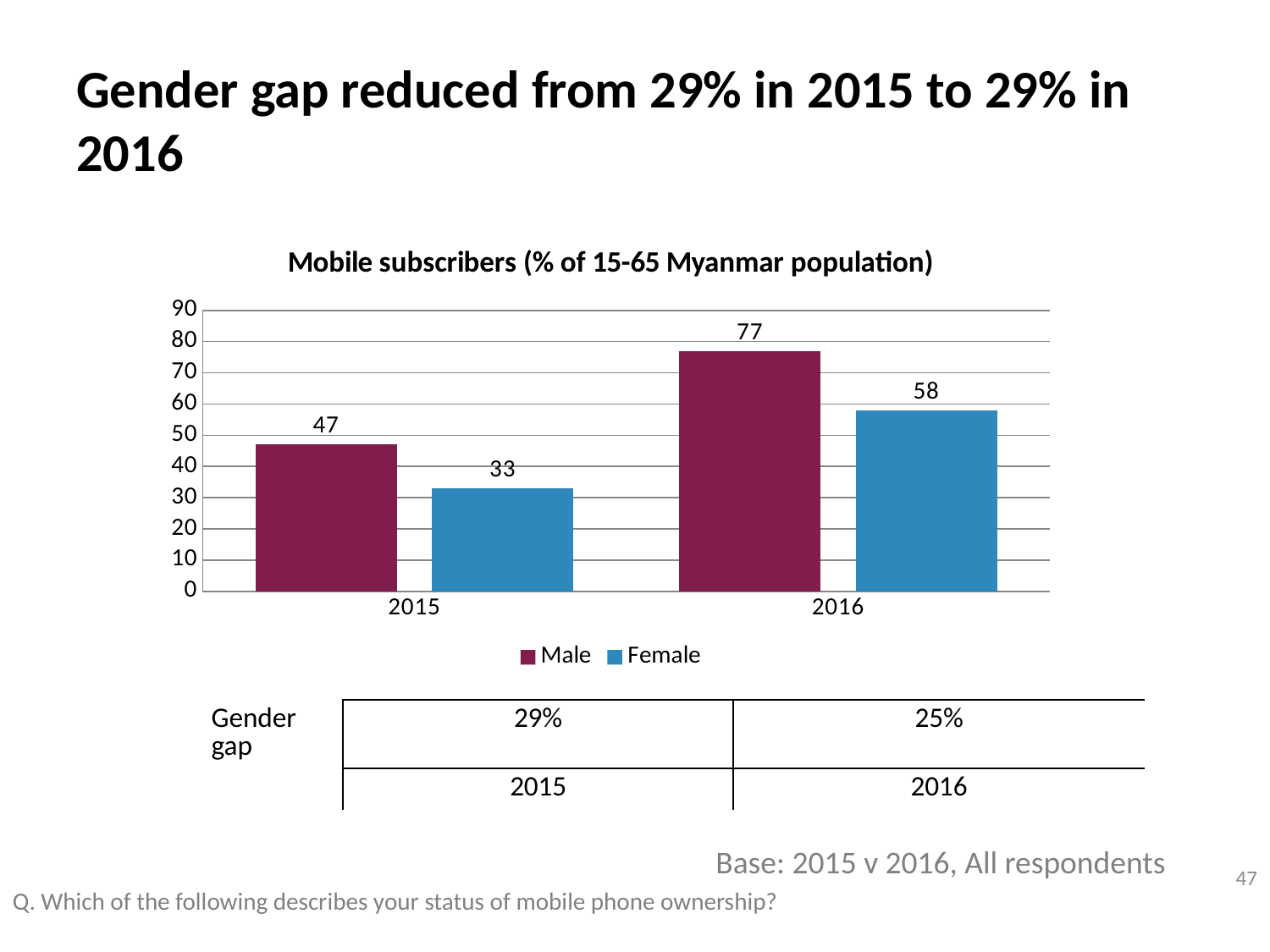
Which bar has the lowest value on the chart? Female in 2015 What is the title of the chart? Mobile subscribers (% of 15-65 Myanmar population) Do the Female values rise or fall from 2015 to 2016? Rise What is the difference between the Male and Female values in 2015? 14 What is the value for Male in 2015? 47 What is the difference between the Male values in 2016 and 2015? 30 What is the value for Female in 2016? 58 Which series has the highest value in 2016? Male Which is larger, the Female value in 2016 or the Male value in 2015? Female in 2016 How many series does the legend list? 2 What kind of chart is shown? Bar chart What is the value for Male in 2016? 77